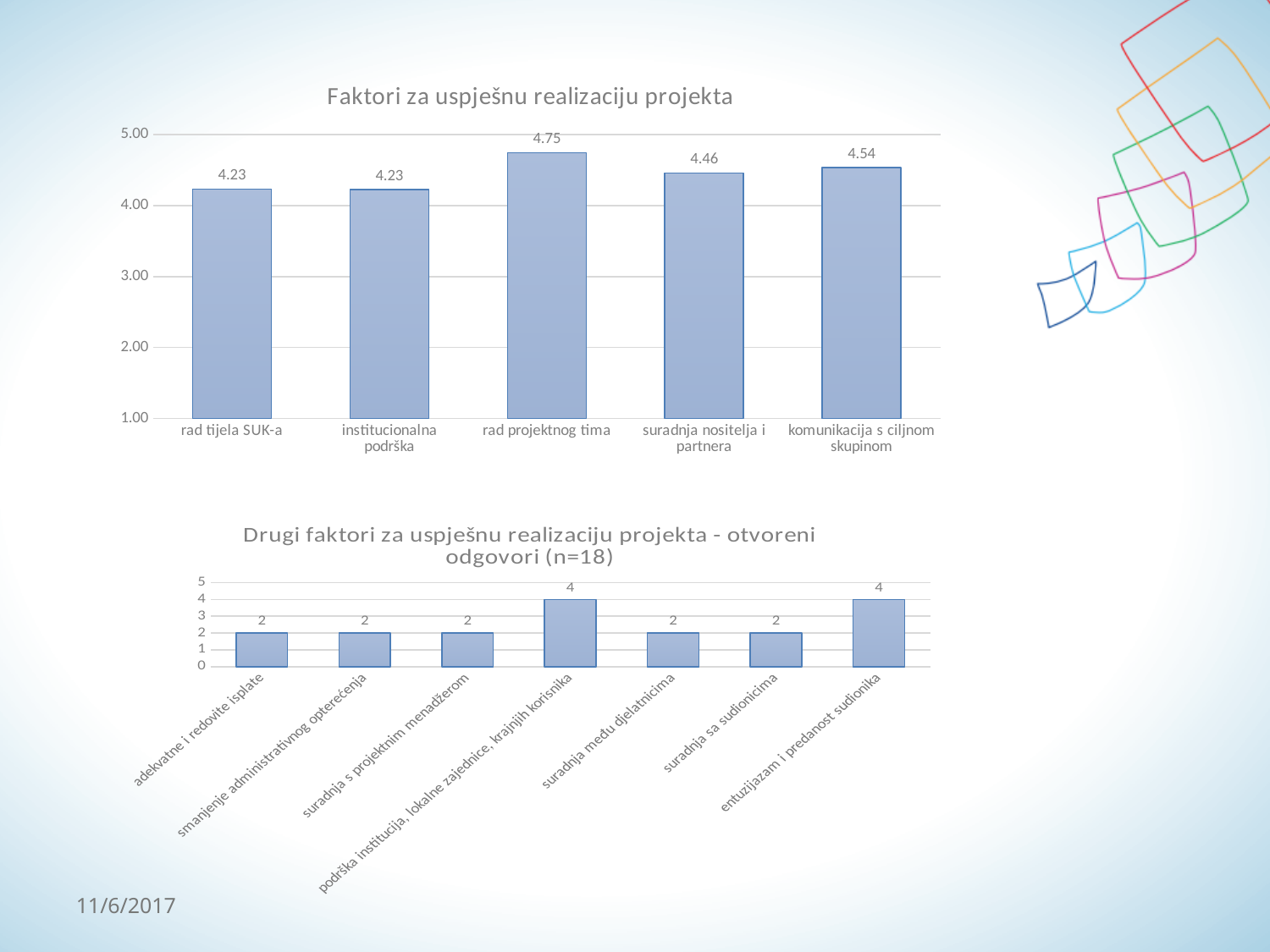
In the chart 'Faktori za uspješnu realizaciju projekta', what is the value for 'komunikacija s ciljnom skupinom'? 4.54 In the chart 'Faktori za uspješnu realizaciju projekta', is the value for 'institucionalna podrška' greater or less than 4.00? greater In the chart 'Faktori za uspješnu realizaciju projekta', how many categories are shown? 5 In the bottom chart 'Drugi faktori za uspješnu realizaciju projekta - otvoreni odgovori (n=18)', how many categories are shown? 7 In the bottom chart 'Drugi faktori za uspješnu realizaciju projekta - otvoreni odgovori (n=18)', which is larger: 'adekvatne i redovite isplate' or 'podrška institucija, lokalne zajednice, krajnjih korisnika'? podrška institucija, lokalne zajednice, krajnjih korisnika In the chart 'Faktori za uspješnu realizaciju projekta', what is the value for 'rad projektnog tima'? 4.75 In the chart 'Faktori za uspješnu realizaciju projekta', what is the difference between 'rad projektnog tima' and 'suradnja nositelja i partnera'? 0.29 In the bottom chart 'Drugi faktori za uspješnu realizaciju projekta - otvoreni odgovori (n=18)', what is the value for 'suradnja sa sudionicima'? 2 What type of chart is the top chart 'Faktori za uspješnu realizaciju projekta'? bar chart In the chart 'Faktori za uspješnu realizaciju projekta', which is larger: 'suradnja nositelja i partnera' or 'komunikacija s ciljnom skupinom'? komunikacija s ciljnom skupinom In the chart 'Faktori za uspješnu realizaciju projekta', which category has the highest value? rad projektnog tima In the bottom chart 'Drugi faktori za uspješnu realizaciju projekta - otvoreni odgovori (n=18)', what is the value for 'entuzijazam i predanost sudionika'? 4